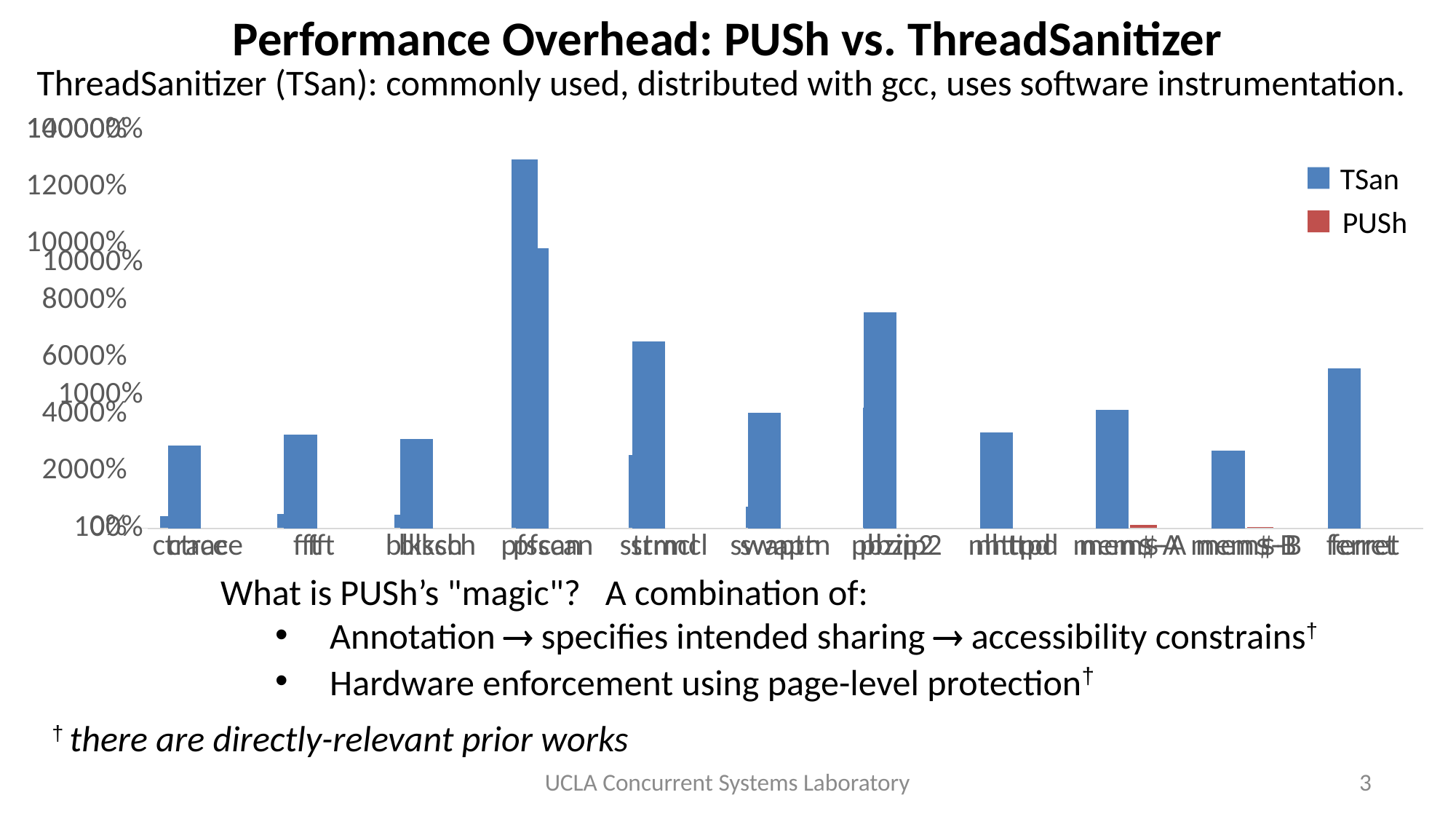
How many series does the chart legend list? 2 Is the TSan value for fft greater or less than 6000%? less Is the TSan value for pfscan greater or less than 12000%? greater How many benchmark categories are plotted along the x axis? 11 Which colour represents the PUSh series in the chart? red For the ferret benchmark, which series has the larger overhead, TSan or PUSh? TSan What are the two series named in the chart legend? TSan and PUSh For the pbzip2 benchmark, which series has the larger overhead, TSan or PUSh? TSan What kind of chart is shown on the slide? bar chart Which benchmark has the tallest TSan bar? pfscan